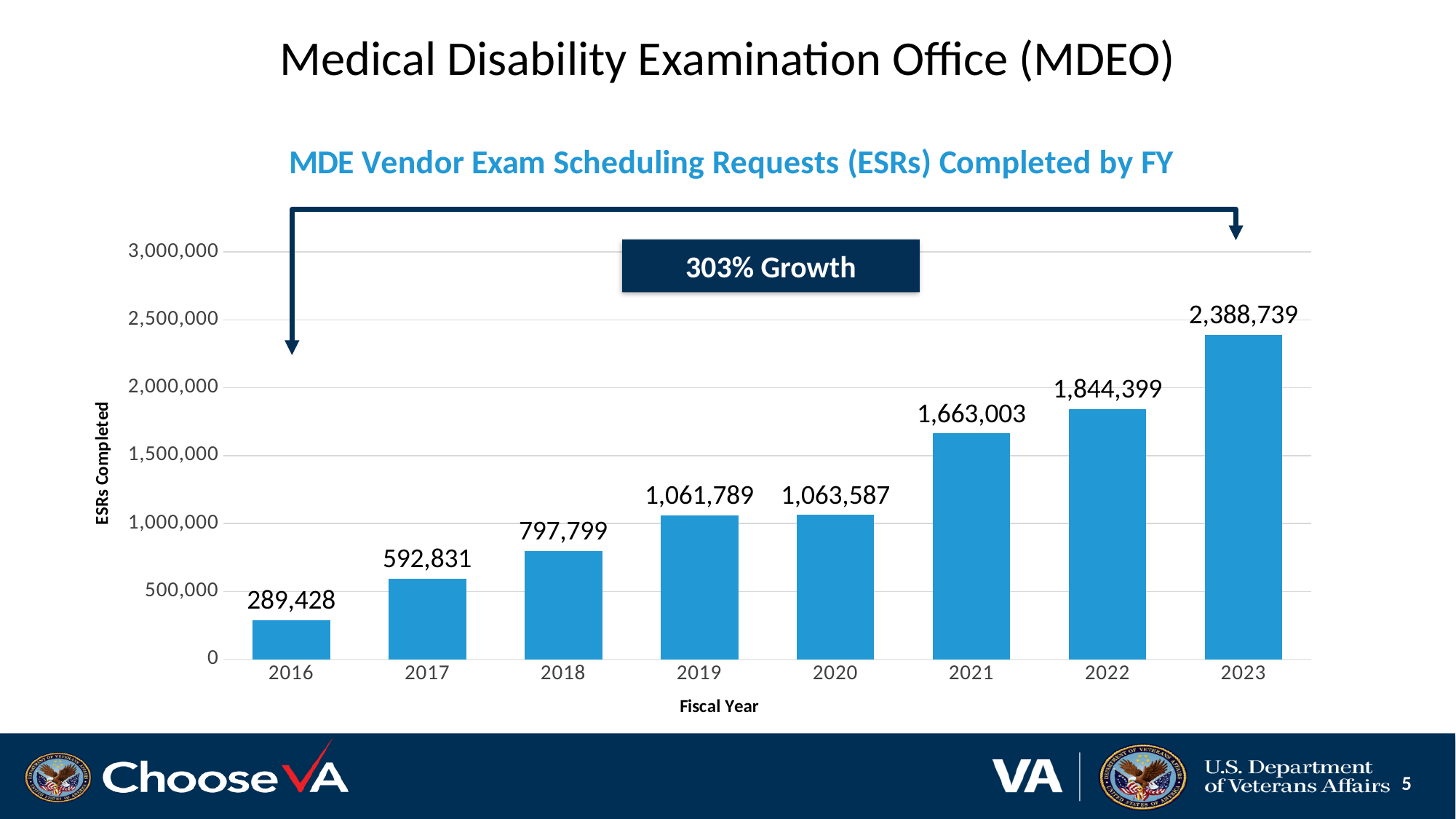
Which fiscal year has more ESRs completed, 2017 or 2022? 2022 What is the number of ESRs completed in FY 2016? 289,428 What is the difference in ESRs completed between FY 2022 and FY 2021? 181,396 Is the value for FY 2022 greater or less than 2,000,000? less What growth percentage is shown in the callout box on the chart? 303% Growth Which fiscal year has the lowest number of ESRs completed? 2016 What is the number of ESRs completed in FY 2021? 1,663,003 Which fiscal year has the highest number of ESRs completed? 2023 What is the difference in ESRs completed between FY 2023 and FY 2016? 2,099,311 What type of chart is shown on the slide? bar chart How many fiscal years are plotted in the chart? 8 What is the number of ESRs completed in FY 2018? 797,799